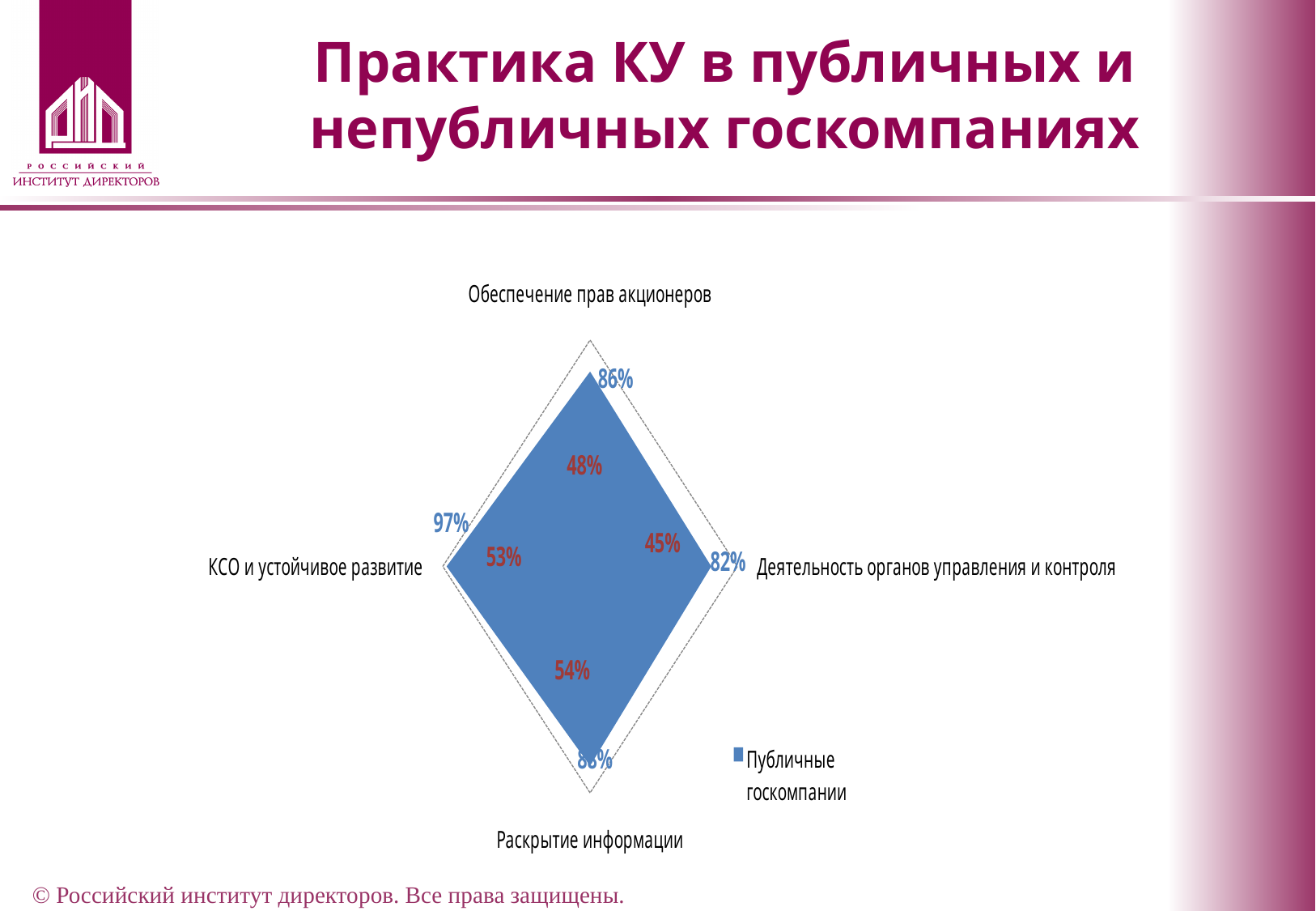
What kind of chart is shown on the slide? radar chart What is the value for Публичные госкомпании on the Деятельность органов управления и контроля axis? 82% Which axis has the lowest red data label value? Деятельность органов управления и контроля What is the difference between the Публичные госкомпании values for КСО и устойчивое развитие and Деятельность органов управления и контроля? 15 percentage points What series name is shown in the legend? Публичные госкомпании What is the value for Публичные госкомпании on the Обеспечение прав акционеров axis? 86% On which axis does the Публичные госкомпании series have its highest value? КСО и устойчивое развитие What is the value for Публичные госкомпании on the КСО и устойчивое развитие axis? 97% What is the red data label shown near the Обеспечение прав акционеров axis? 48% How many series does the legend list? 1 How many axes (categories) does the radar chart have? 4 For Публичные госкомпании, which is larger: the value for Обеспечение прав акционеров or for Деятельность органов управления и контроля? Обеспечение прав акционеров